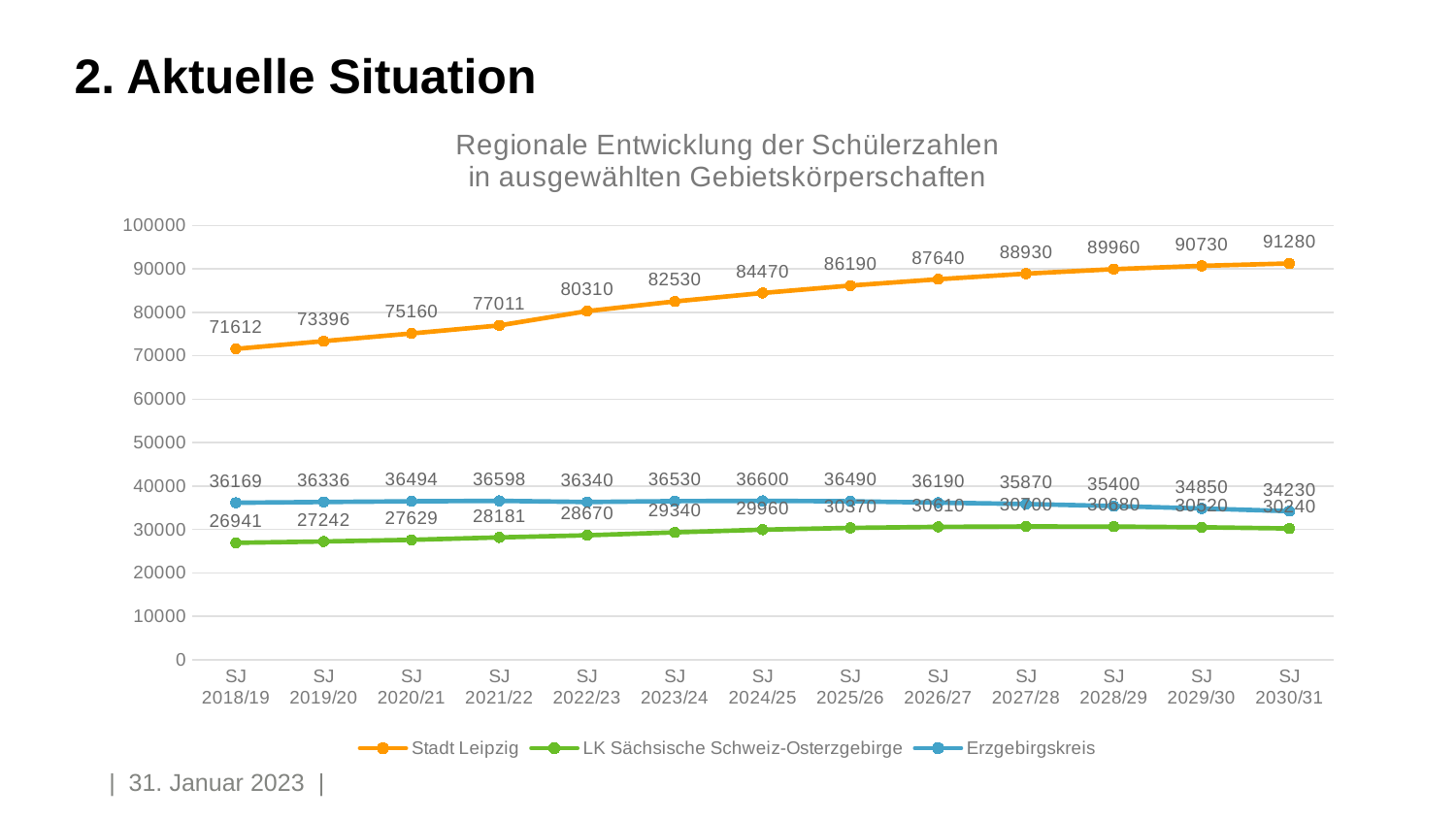
What is the value for LK Sächsische Schweiz-Osterzgebirge in SJ 2021/22? 28181 What is the value for Stadt Leipzig in SJ 2030/31? 91280 Which is larger in SJ 2018/19: the value for Erzgebirgskreis or for LK Sächsische Schweiz-Osterzgebirge? Erzgebirgskreis What is the value for Erzgebirgskreis in SJ 2024/25? 36600 Which series has the highest values across all school years? Stadt Leipzig How many school years (data points) are shown on the x axis? 13 Do the values for Stadt Leipzig rise or fall from SJ 2018/19 to SJ 2030/31? rise What is the difference between the Stadt Leipzig values in SJ 2030/31 and SJ 2018/19? 19668 In which school year does Erzgebirgskreis reach its lowest value? SJ 2030/31 What is the value for Stadt Leipzig in SJ 2018/19? 71612 What type of chart is shown on the slide? line chart How many series does the legend list? 3